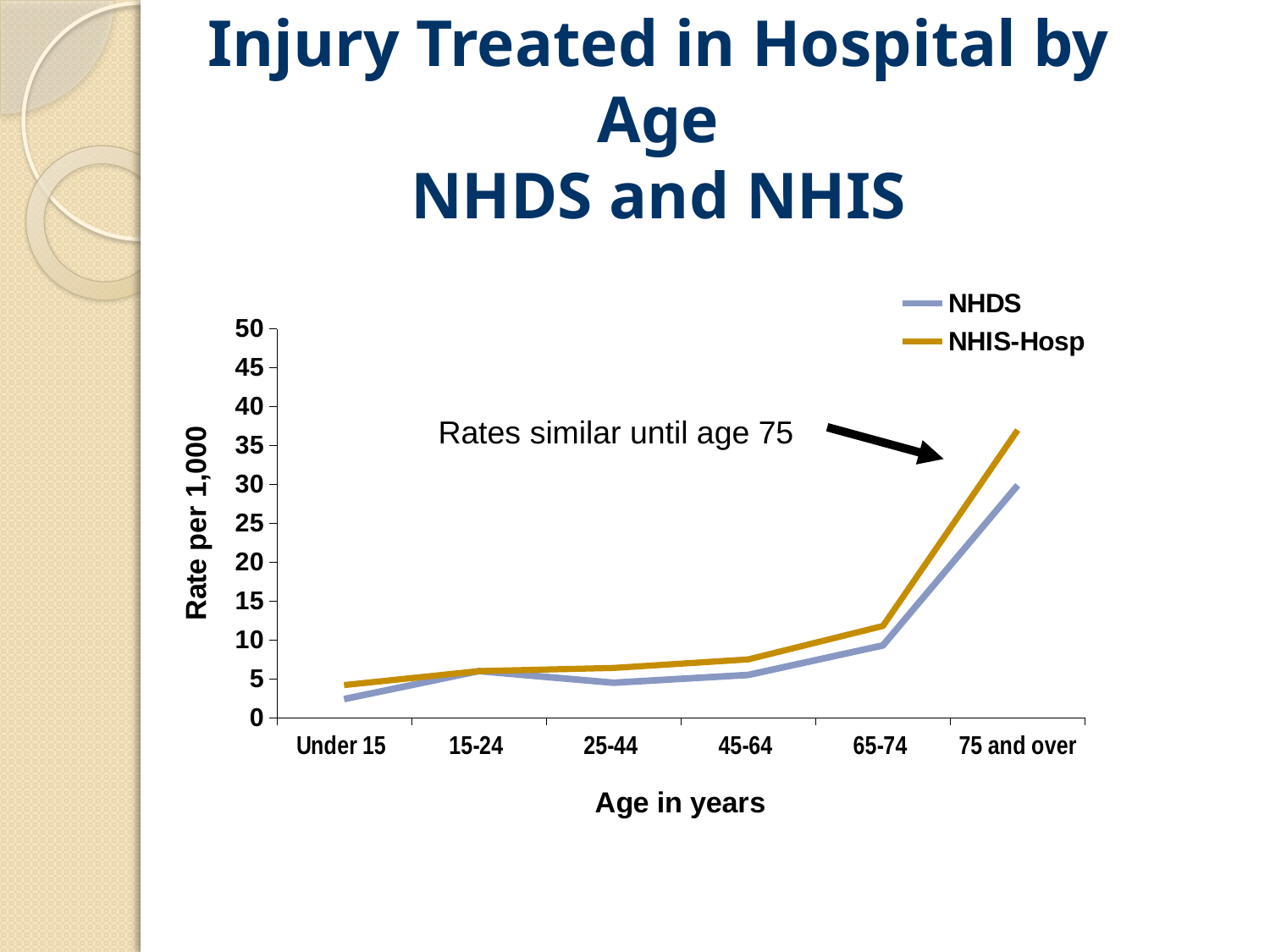
What kind of chart is shown on the slide? line chart Is the NHDS value for Under 15 greater or less than 5? less For the 75 and over age group, which series has the larger value, NHDS or NHIS-Hosp? NHIS-Hosp How many age categories are shown on the x axis? 6 Do the NHIS-Hosp values generally rise or fall as age increases along the x axis? rise How many series does the legend list? 2 Is the NHIS-Hosp value for 75 and over greater or less than 35? greater Which age group has the lowest rate for the NHDS series? Under 15 Is the NHDS value for 75 and over greater or less than 25? greater Which age group has the highest rate for the NHIS-Hosp series? 75 and over What is the label on the y axis of the chart? Rate per 1,000